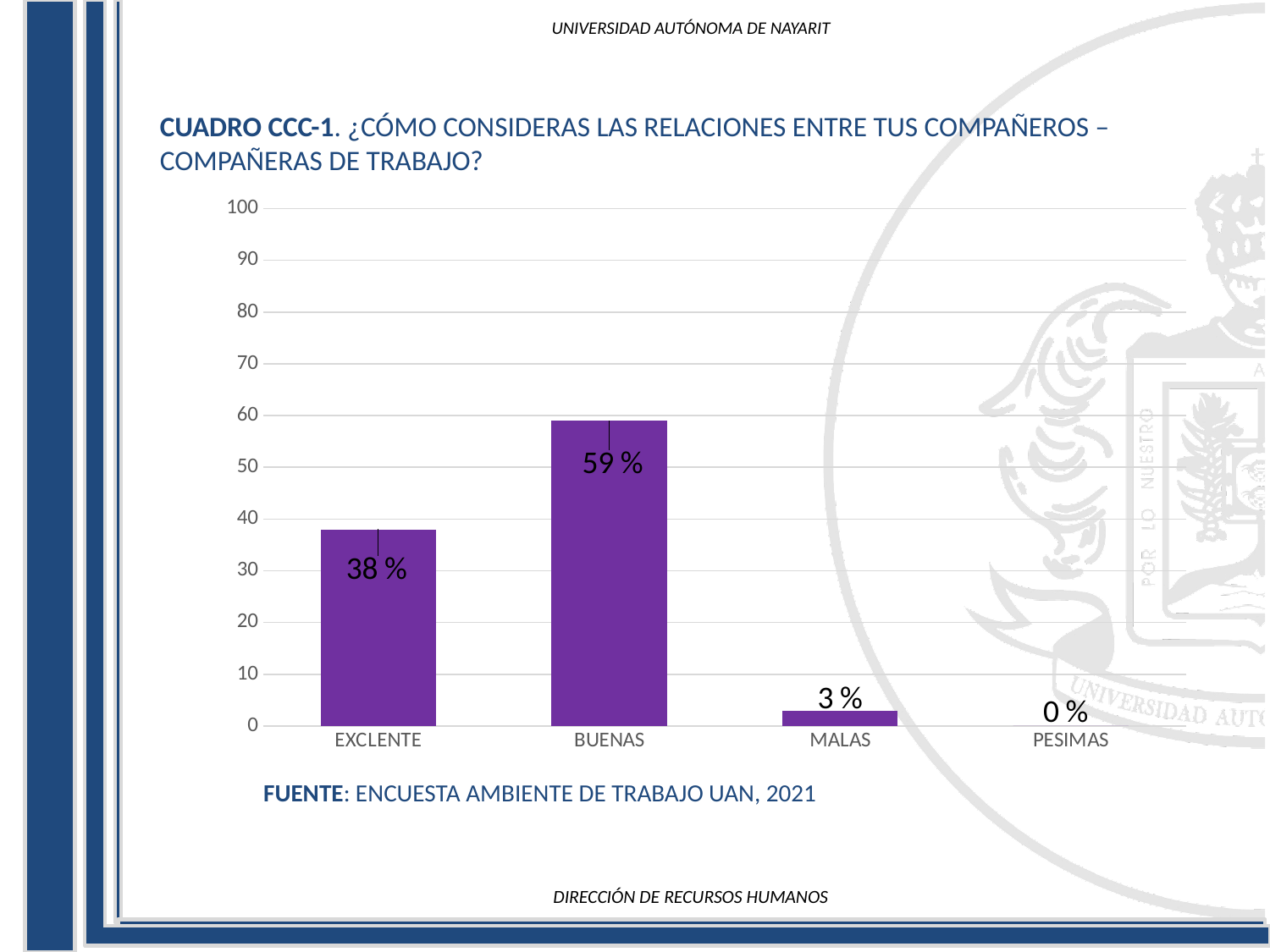
How many categories are shown on the x axis? 4 What source is cited below the chart? ENCUESTA AMBIENTE DE TRABAJO UAN, 2021 Which category has the highest value? BUENAS What kind of chart is shown on the slide? bar chart Is the value for BUENAS greater or less than 50? greater What is the value for MALAS? 3 % What is the value for PESIMAS? 0 % What is the value for EXCLENTE? 38 % Which category has the lowest value? PESIMAS What is the difference between the values for BUENAS and EXCLENTE? 21 % What is the value for BUENAS? 59 % Which is larger, the value for EXCLENTE or the value for MALAS? EXCLENTE